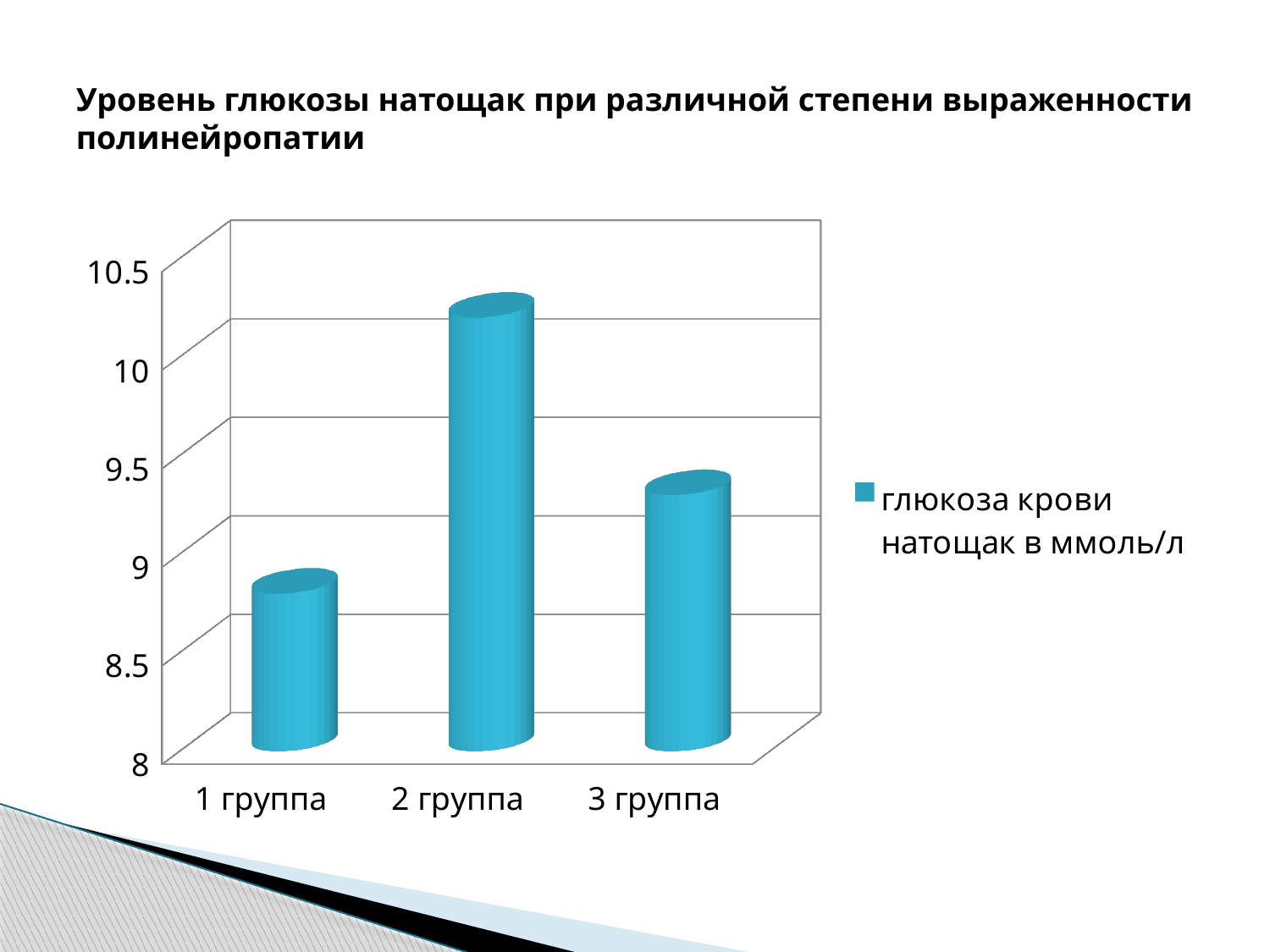
How many series does the legend list? 1 Which group has the lowest fasting blood glucose level? 1 группа How many groups (categories) are shown on the x axis? 3 Is the value for 1 группа greater or less than 9? less Is the value for 3 группа greater or less than 9? greater What type of chart is shown on the slide? bar chart Is the value for 2 группа greater or less than 10? greater What is the legend entry for the series shown in the chart? глюкоза крови натощак в ммоль/л Which group has the highest fasting blood glucose level? 2 группа Which is larger, the value for 3 группа or the value for 1 группа? 3 группа What is the title of the slide containing the chart? Уровень глюкозы натощак при различной степени выраженности полинейропатии